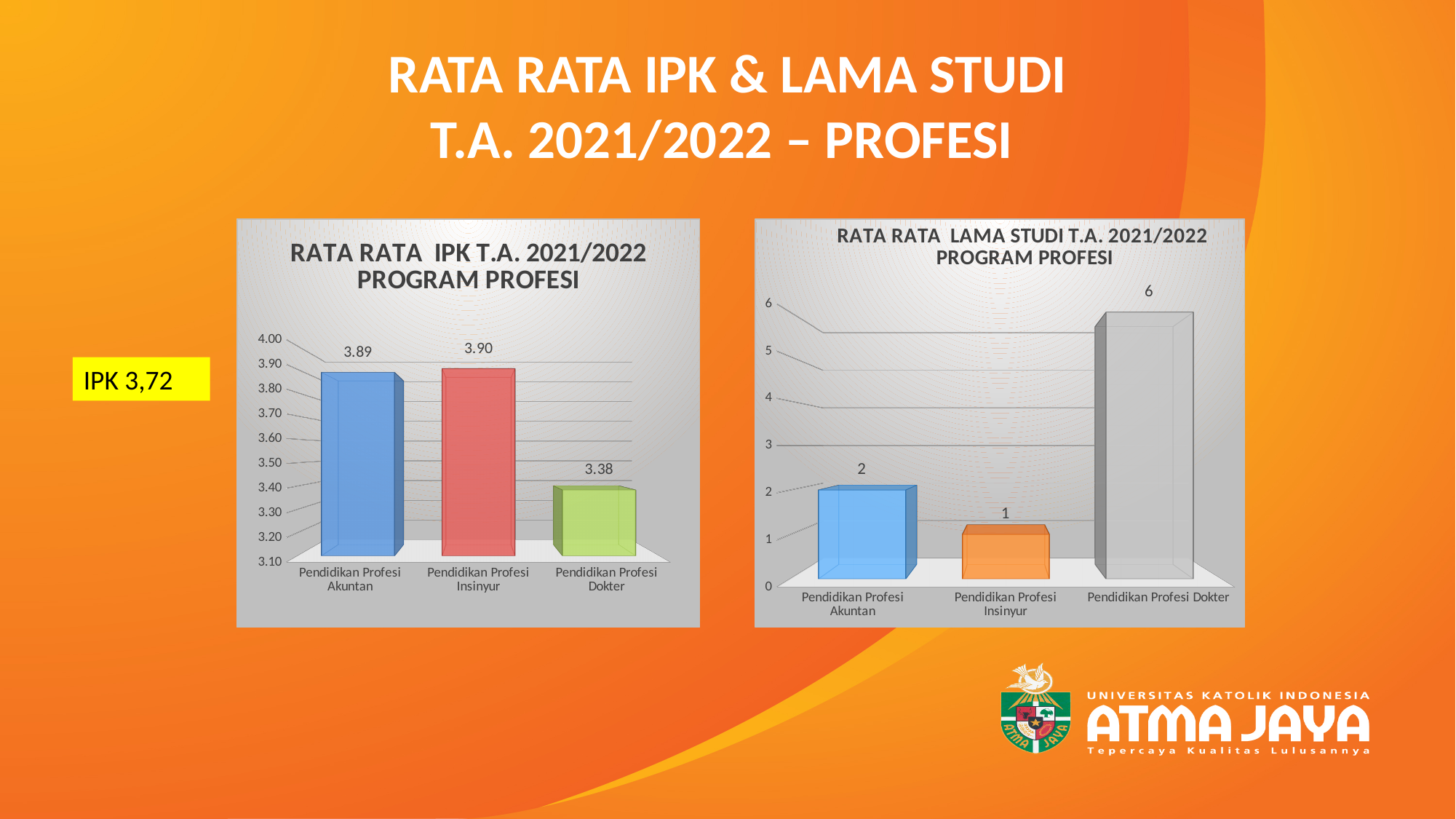
In the right chart (RATA RATA LAMA STUDI T.A. 2021/2022 PROGRAM PROFESI), what is the value for Pendidikan Profesi Insinyur? 1 What kind of chart is the right chart (RATA RATA LAMA STUDI T.A. 2021/2022 PROGRAM PROFESI)? Bar chart In the left chart (RATA RATA IPK T.A. 2021/2022 PROGRAM PROFESI), what is the value for Pendidikan Profesi Akuntan? 3.89 In the left chart (RATA RATA IPK T.A. 2021/2022 PROGRAM PROFESI), how many categories are shown? 3 In the left chart (RATA RATA IPK T.A. 2021/2022 PROGRAM PROFESI), what is the difference between the values for Pendidikan Profesi Akuntan and Pendidikan Profesi Dokter? 0.51 In the left chart (RATA RATA IPK T.A. 2021/2022 PROGRAM PROFESI), what is the value for Pendidikan Profesi Dokter? 3.38 In the right chart (RATA RATA LAMA STUDI T.A. 2021/2022 PROGRAM PROFESI), what is the difference between the values for Pendidikan Profesi Dokter and Pendidikan Profesi Akuntan? 4 In the left chart (RATA RATA IPK T.A. 2021/2022 PROGRAM PROFESI), which category has the lowest value? Pendidikan Profesi Dokter In the right chart (RATA RATA LAMA STUDI T.A. 2021/2022 PROGRAM PROFESI), which category has the highest value? Pendidikan Profesi Dokter In the right chart (RATA RATA LAMA STUDI T.A. 2021/2022 PROGRAM PROFESI), what is the value for Pendidikan Profesi Dokter? 6 In the right chart (RATA RATA LAMA STUDI T.A. 2021/2022 PROGRAM PROFESI), which is larger, the value for Pendidikan Profesi Akuntan or Pendidikan Profesi Insinyur? Pendidikan Profesi Akuntan In the right chart (RATA RATA LAMA STUDI T.A. 2021/2022 PROGRAM PROFESI), which category has the lowest value? Pendidikan Profesi Insinyur